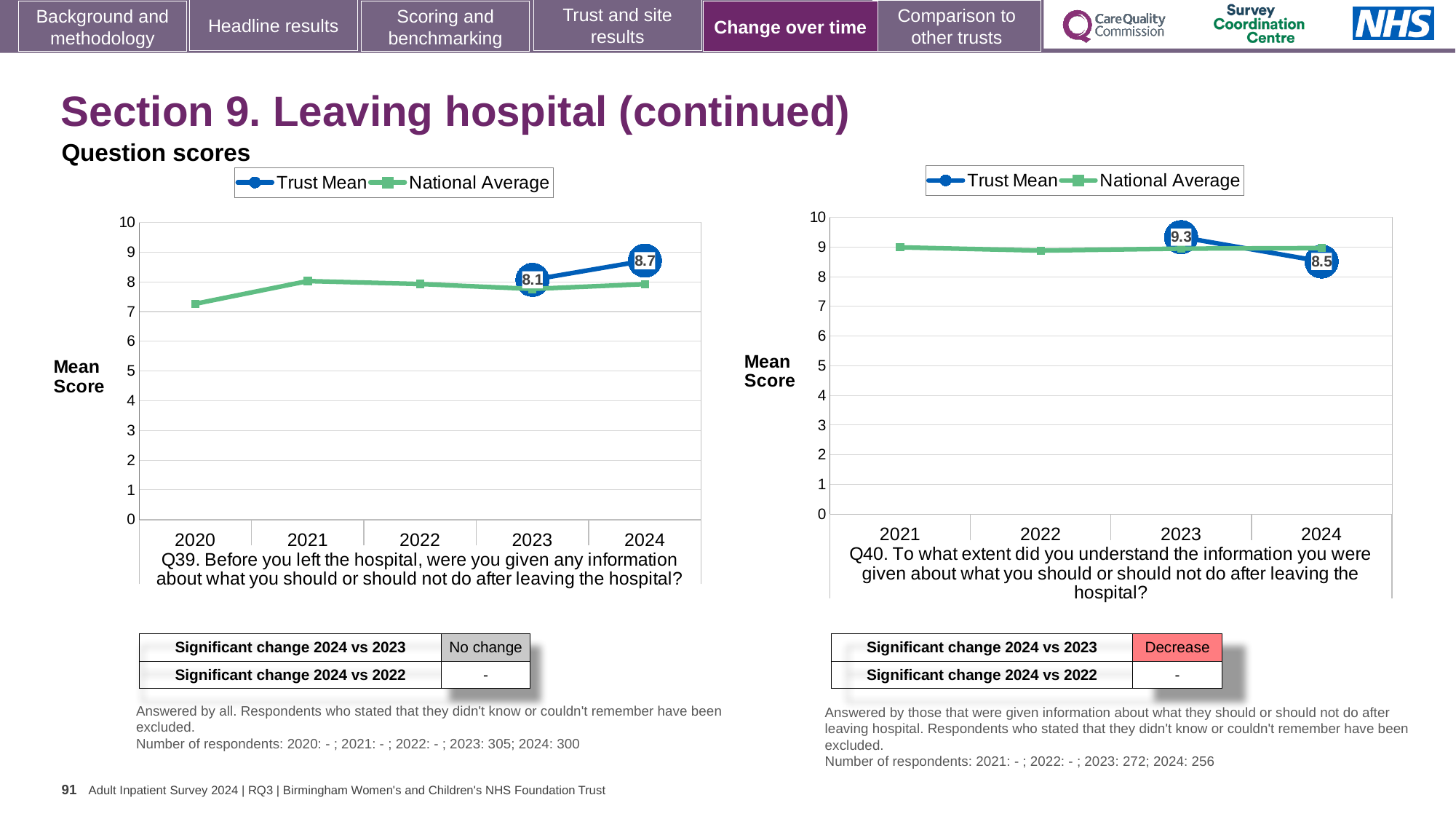
In the Q39 chart on the left, by how much did the Trust Mean change from 2023 to 2024? 0.6 What type of chart is the Q39 chart on the left? line chart In the Q39 chart on the left, what is the Trust Mean score for 2023? 8.1 In the Q40 chart on the right, what is the Trust Mean score for 2023? 9.3 In the Q39 chart on the left, what is the Trust Mean score for 2024? 8.7 How many years are shown on the x axis of the Q39 chart on the left? 5 In the Q39 chart on the left, did the Trust Mean rise or fall from 2023 to 2024? rise In the Q40 chart on the right, did the Trust Mean rise or fall from 2023 to 2024? fall How many series does the legend of the Q40 chart on the right list? 2 In the Q39 chart on the left, is the National Average for 2020 greater or less than 8? less In the Q40 chart on the right, what is the difference between the Trust Mean in 2023 and 2024? 0.8 In the Q40 chart on the right, what is the Trust Mean score for 2024? 8.5